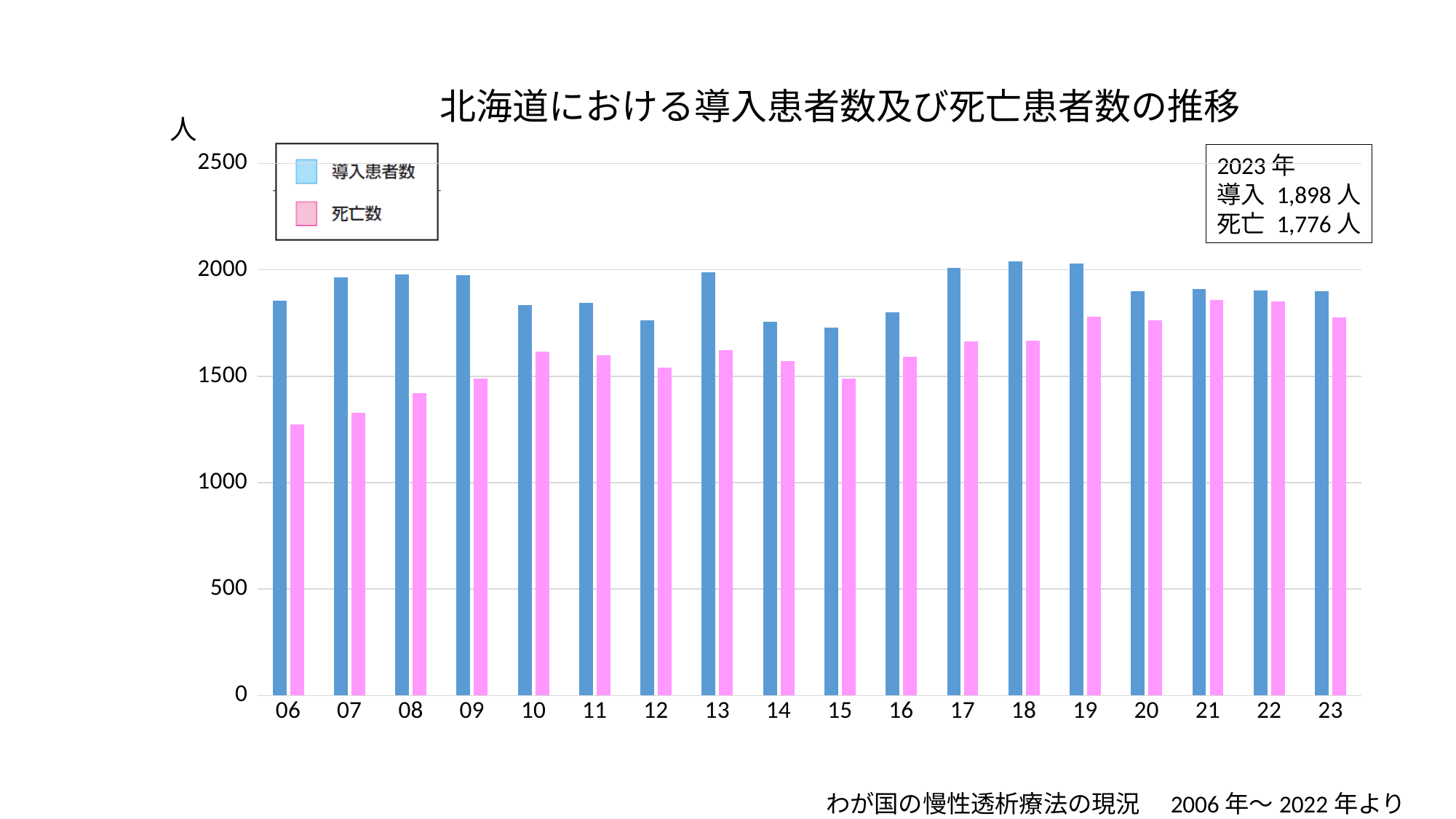
Is the 死亡数 value for 10 greater or less than 1500? greater According to the text box, what is the 死亡 value for 2023? 1,776 人 What kind of chart is shown on the slide? bar chart Is the 死亡数 value for 06 greater or less than 1500? less How many series does the legend list? 2 Which year has the lowest 死亡数 value? 06 What is the title of the chart? 北海道における導入患者数及び死亡患者数の推移 According to the text box, what is the 導入 value for 2023? 1,898 人 In 06, which is larger: 導入患者数 or 死亡数? 導入患者数 Is the 導入患者数 value for 15 greater or less than 2000? less What is the difference between the 2023 導入 value and the 2023 死亡 value given in the text box? 122 人 How many years are shown along the x axis? 18